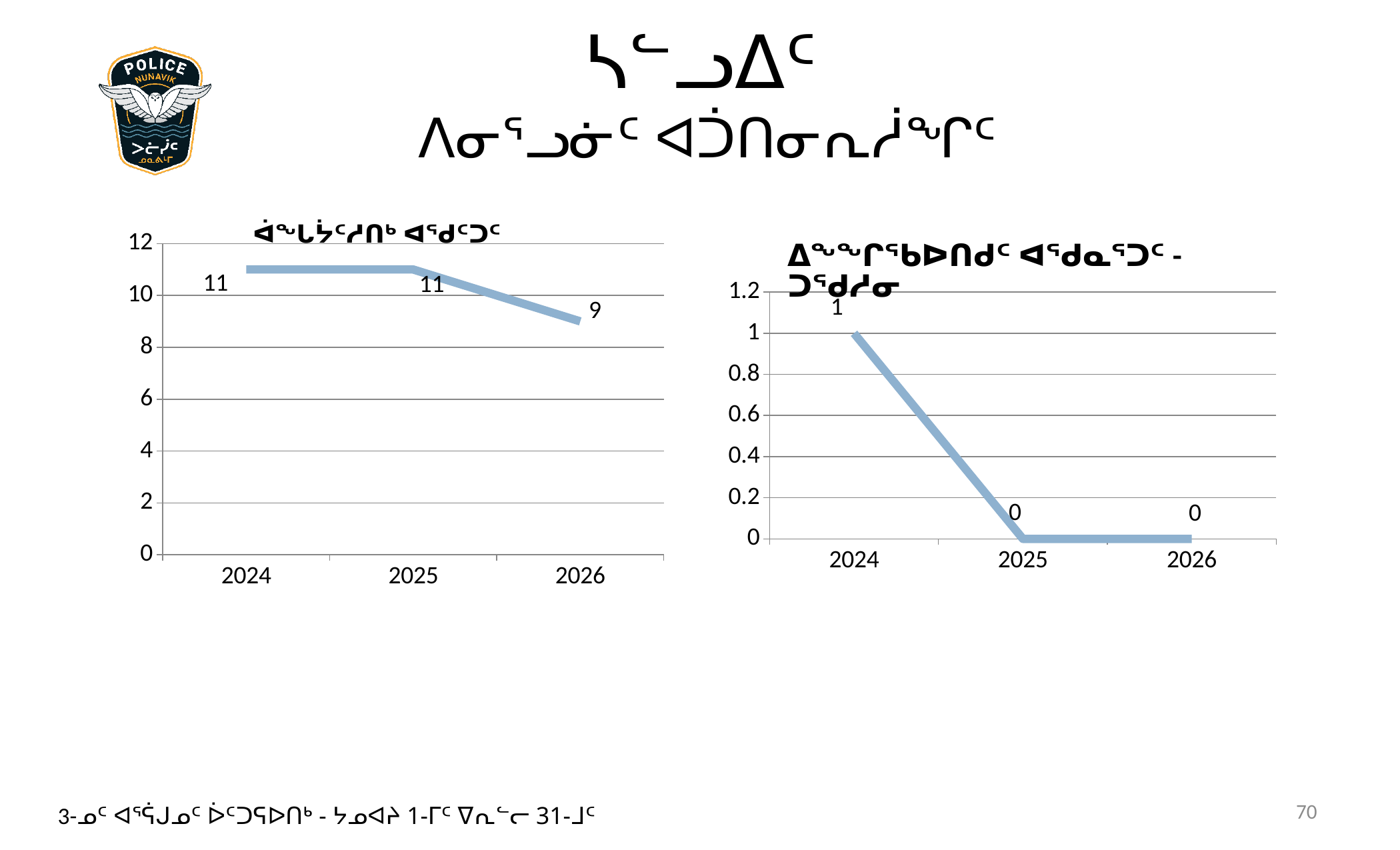
In the right chart, what is the difference between the values for 2024 and 2026? 1 In the right chart, what is the value for 2024? 1 In the right chart, do the values rise or fall from 2024 to 2025? fall In the left chart, is the value for 2024 larger or smaller than the value for 2026? larger How many years are shown on the x axis of the left chart? 3 What kind of chart is the right chart? line chart In the left chart, what is the value for 2024? 11 In the left chart, what is the difference between the values for 2025 and 2026? 2 In the right chart, which year has the highest value? 2024 In the left chart, what is the value for 2026? 9 In the left chart, which year has the lowest value? 2026 In the right chart, what is the value for 2025? 0